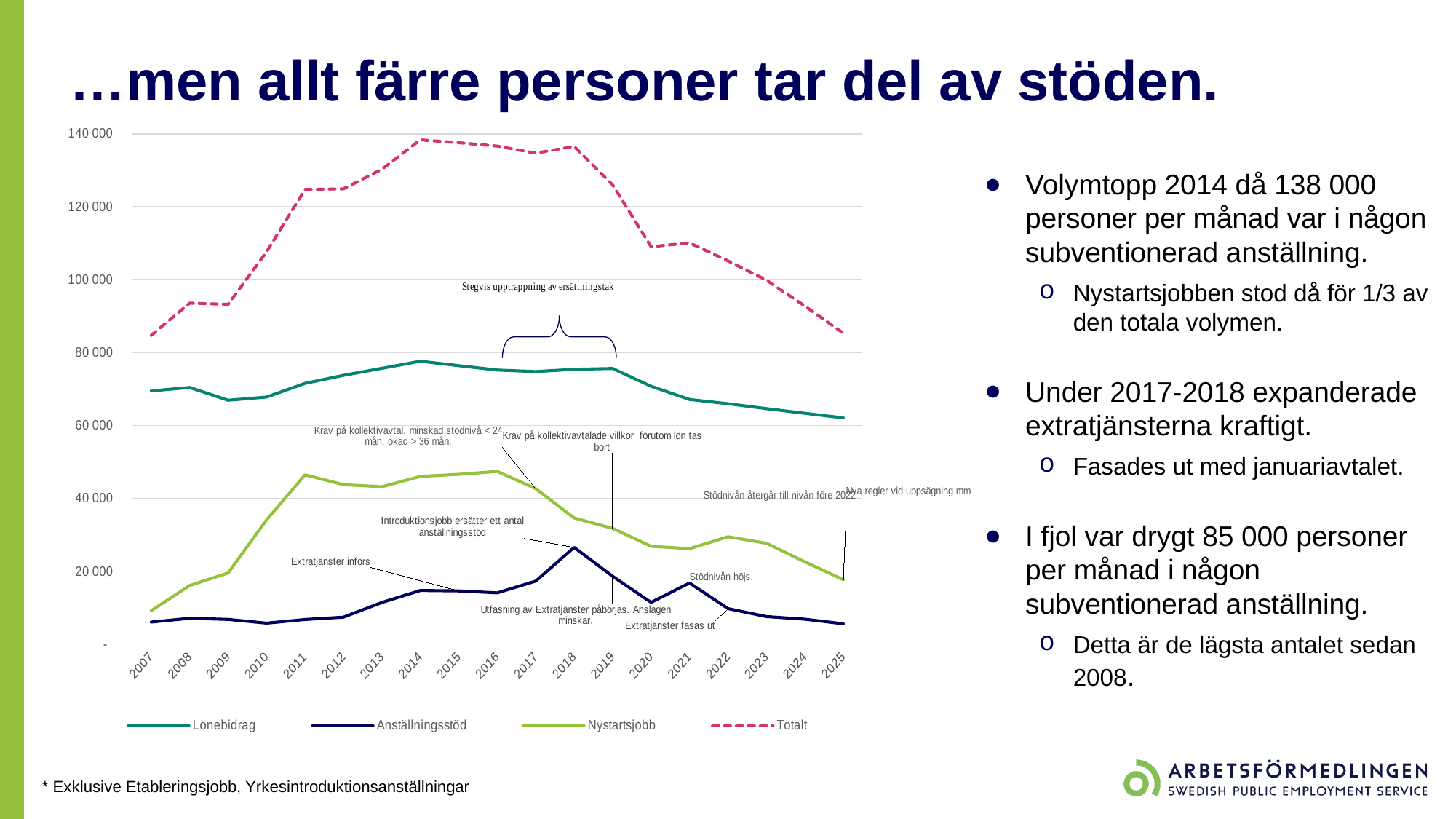
Does the Totalt series rise or fall between 2019 and 2025? fall How many series does the chart legend list? 4 In 2014, which series has the larger value: Lönebidrag or Nystartsjobb? Lönebidrag In which year does the Totalt series reach its highest value? 2014 Which series in the legend is drawn with a dashed line? Totalt What kind of chart is shown on the slide? line chart Is the value for Totalt in 2020 greater or less than 120 000? less Is the value for Nystartsjobb in 2011 greater or less than 40 000? greater In which year does the Anställningsstöd series reach its highest value? 2018 How many years are plotted along the x axis of the chart? 19 Is the value for Anställningsstöd in 2018 greater or less than 20 000? greater